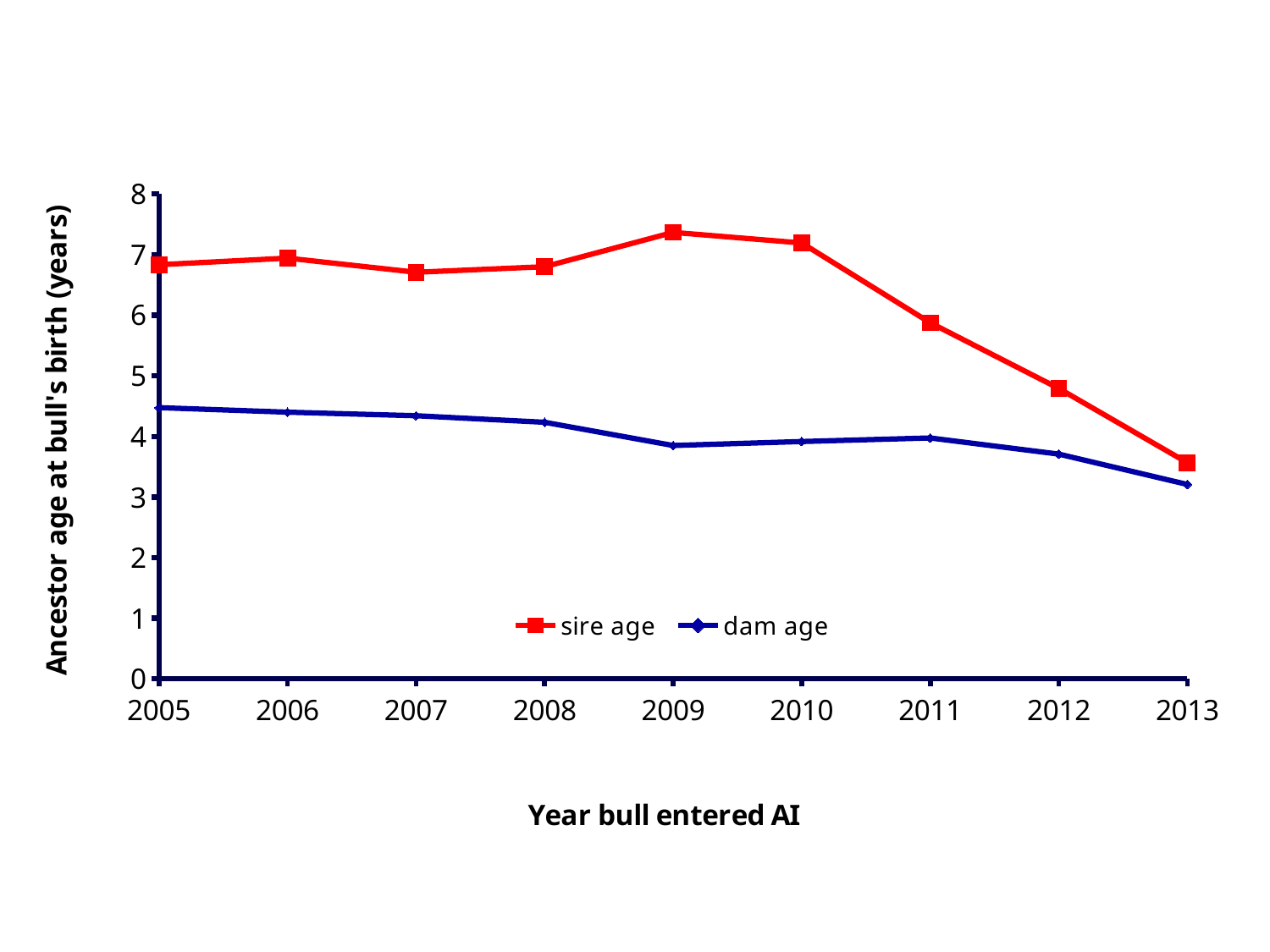
Which is larger in 2010, the sire age or the dam age? sire age Is the sire age in 2011 greater or less than 5? greater How many years are plotted along the x axis? 9 What kind of chart is shown on the slide? line chart In which year is the sire age lowest? 2013 In which year is the dam age lowest? 2013 How many series does the legend list? 2 Which series is plotted in red? sire age Is the dam age in 2009 greater or less than 4? less Does the sire age rise or fall from 2010 to 2013? fall What is the label of the x axis? Year bull entered AI In which year is the sire age highest? 2009